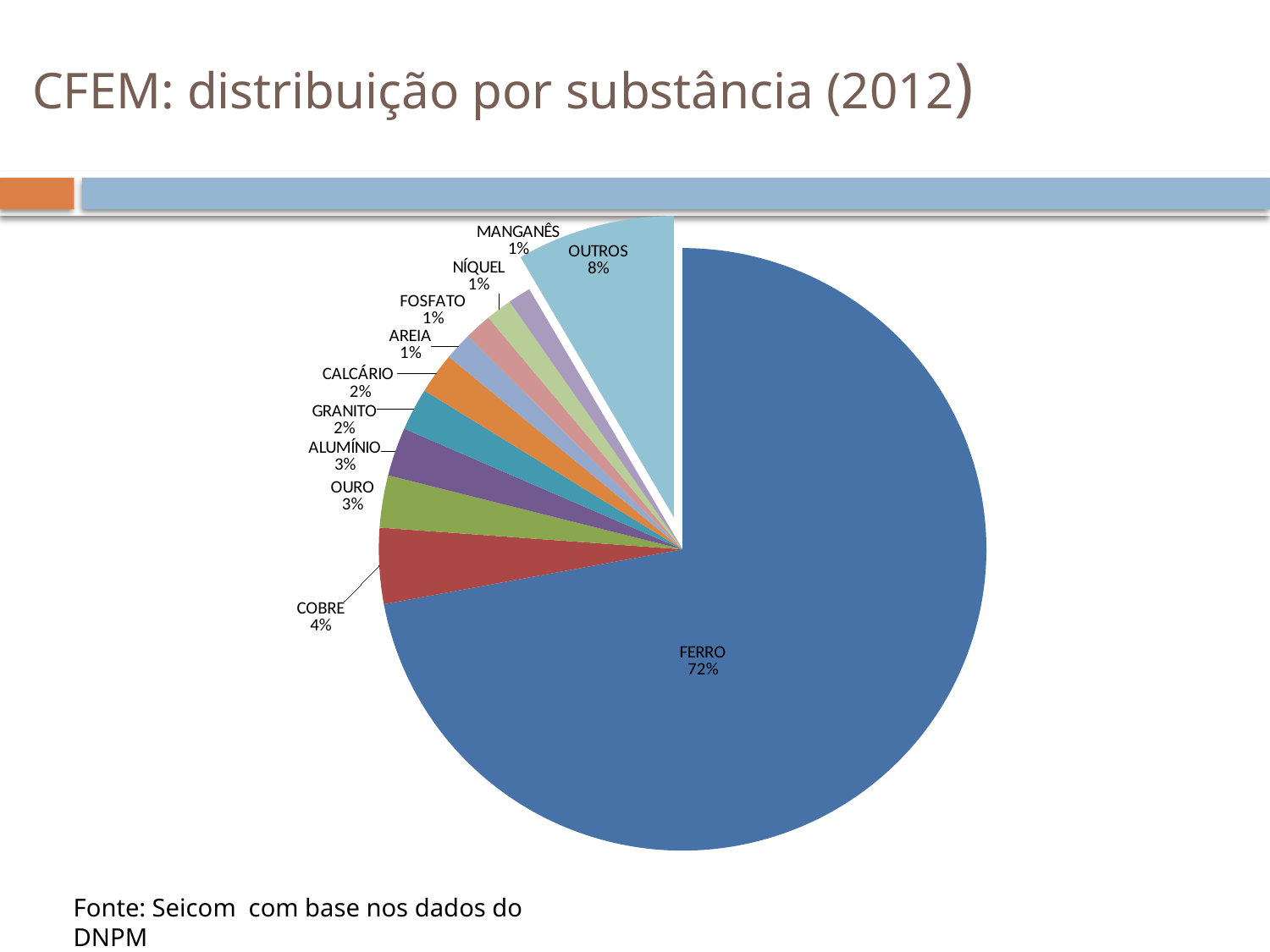
What share of the pie does FERRO represent? 72% What is the difference between the shares of FERRO and OUTROS? 64% Which is larger, the share of OUTROS or the share of COBRE? OUTROS What is the value shown for OUTROS? 8% What is the title of the slide containing the chart? CFEM: distribuição por substância (2012) What kind of chart is shown on the slide? pie chart How many slices does the pie chart have? 11 What is the difference between the shares of COBRE and GRANITO? 2% What is the value shown for ALUMÍNIO? 3% What is the value shown for COBRE? 4% Which substance has the largest slice of the pie? FERRO What is the value shown for CALCÁRIO? 2%